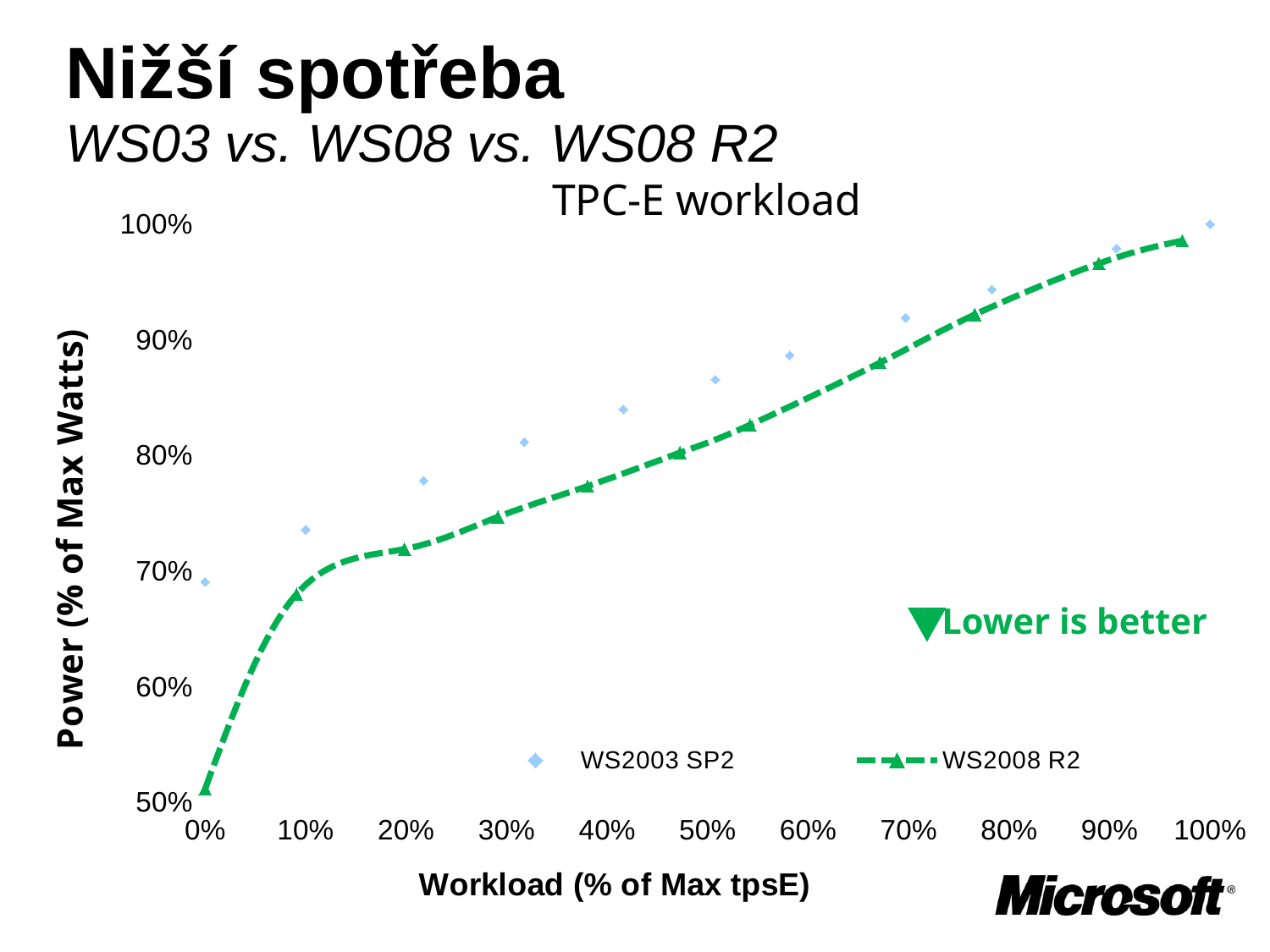
Is the power value for WS2003 SP2 at 50% workload greater or less than 80%? greater How many series does the legend list? 2 What kind of chart is shown on the slide? line chart Is the power value for WS2008 R2 at 40% workload greater or less than 80%? less Is the power value for WS2008 R2 at 0% workload greater or less than 60%? less What are the two series named in the legend? WS2003 SP2 and WS2008 R2 Does the power for WS2008 R2 rise or fall as workload increases along the x axis? rise What is the title of the chart? TPC-E workload At 30% workload, which series shows the lower power: WS2003 SP2 or WS2008 R2? WS2008 R2 How many data points are plotted for the WS2003 SP2 series? 11 At 0% workload, which series shows the higher power: WS2003 SP2 or WS2008 R2? WS2003 SP2